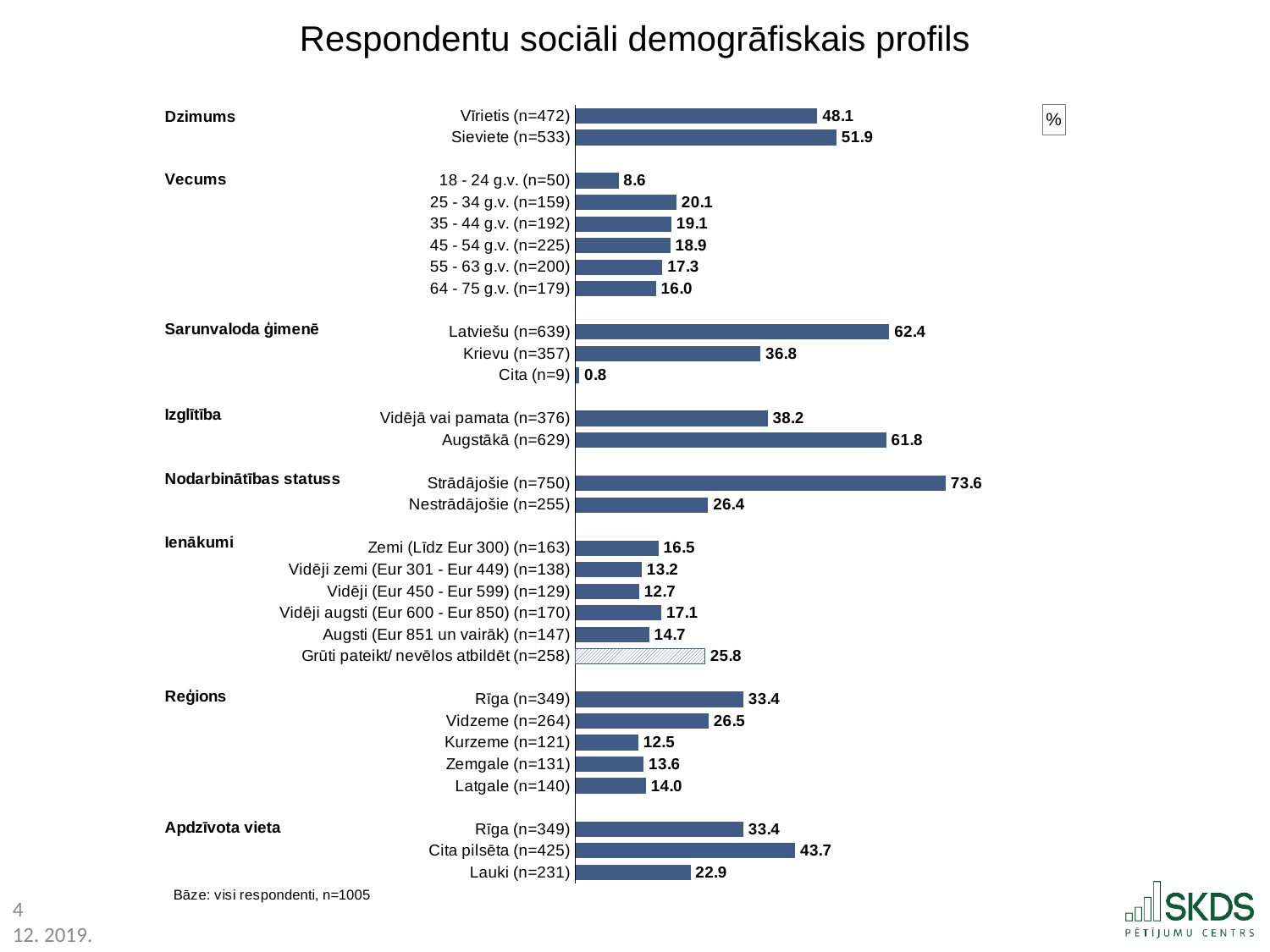
How many bars are plotted on the chart in total? 29 What is the value for Grūti pateikt/ nevēlos atbildēt (n=258)? 25.8 What type of chart is shown on the slide? Bar chart Which bar on the chart has the lowest value? Cita (n=9) Which bar on the chart has the highest value? Strādājošie (n=750) What is the value for Krievu (n=357) in the Sarunvaloda ģimenē group? 36.8 Which is larger, Vidzeme (n=264) or Latgale (n=140)? Vidzeme (n=264) What is the value for Vīrietis (n=472)? 48.1 What is the difference between Augstākā (n=629) and Vidējā vai pamata (n=376)? 23.6 Within the Vecums group, which age category has the lowest value? 18 - 24 g.v. (n=50) What is the title of the chart? Respondentu sociāli demogrāfiskais profils What is the difference between Cita pilsēta (n=425) and Lauki (n=231)? 20.8